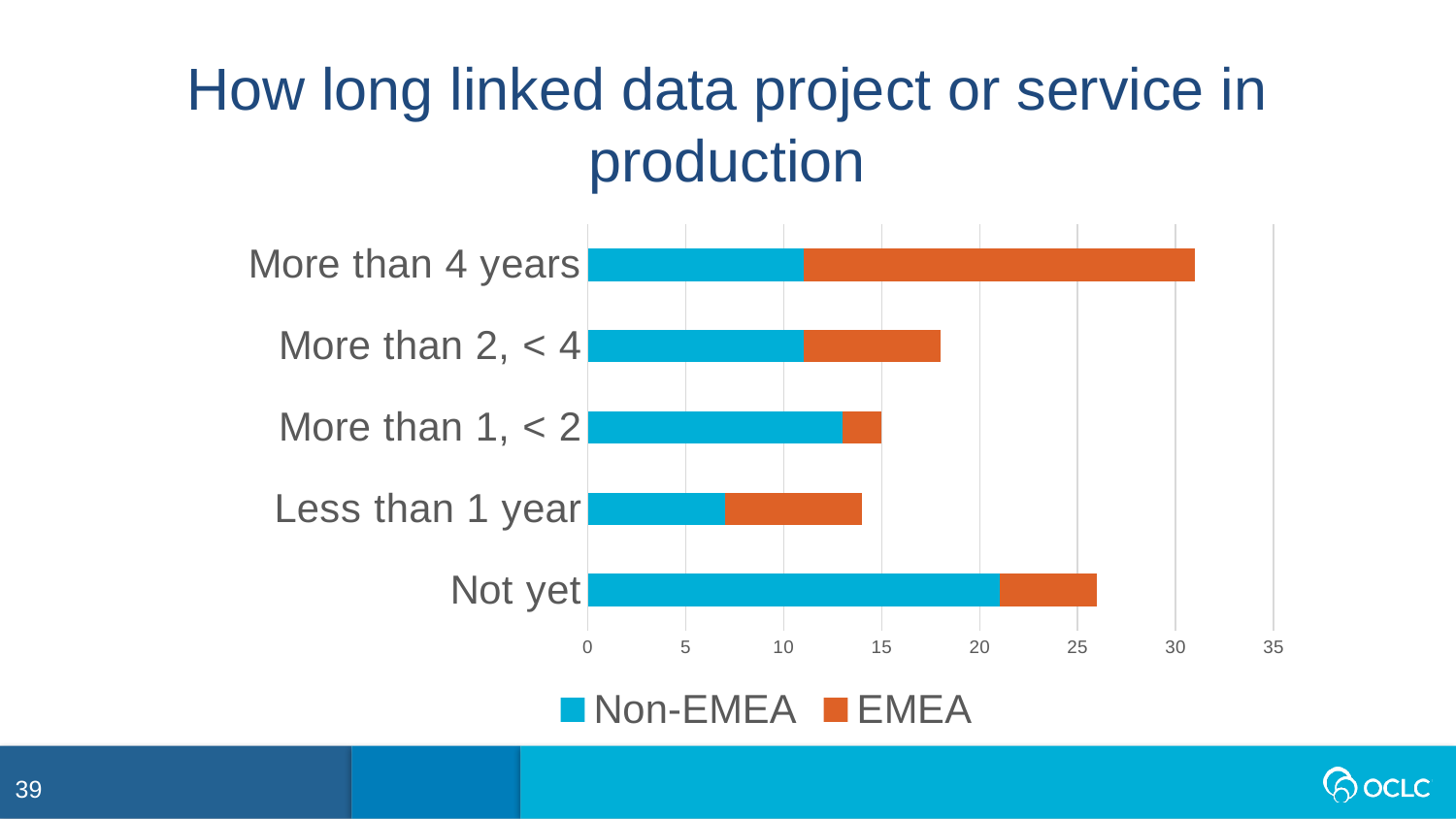
How many series does the legend list? 2 Is the total bar for More than 2, < 4 greater or less than 20? less Which category has the longest total bar? More than 4 years Which category has the smallest Non-EMEA value? Less than 1 year How many categories are shown on the chart? 5 What is the title of the chart? How long linked data project or service in production What kind of chart is shown on the slide? stacked bar chart Which category has the largest EMEA value? More than 4 years Which category has the smallest EMEA value? More than 1, < 2 Is the total bar for More than 4 years greater or less than 25? greater Which has the longer total bar, Not yet or More than 2, < 4? Not yet Which category has the largest Non-EMEA value? Not yet